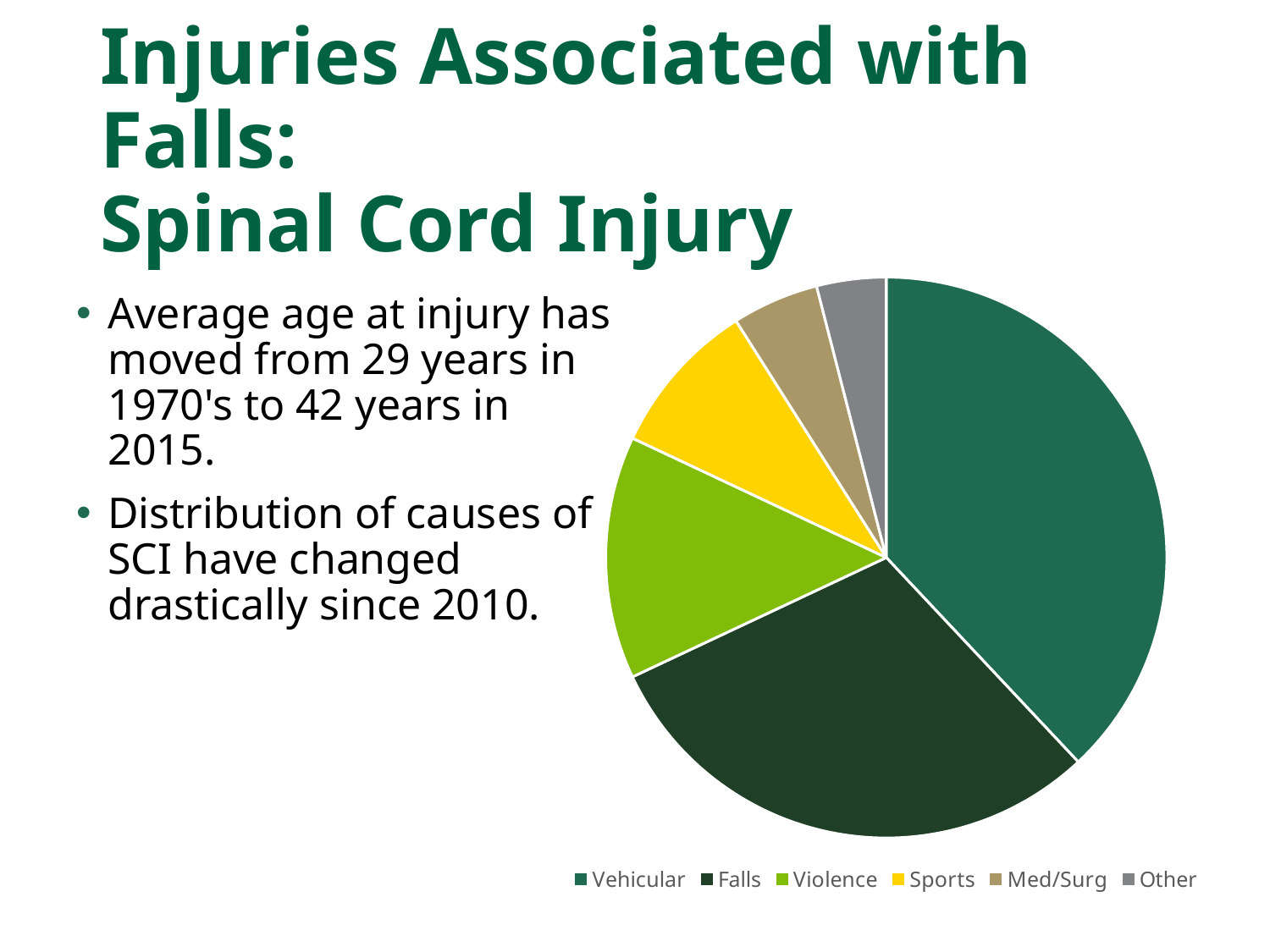
Which slice is larger in the pie chart, Falls or Sports? Falls Which category has the largest slice of the pie chart? Vehicular What kind of chart is shown on the slide? Pie chart Which slice is larger in the pie chart, Vehicular or Falls? Vehicular Which category is listed first in the pie chart's legend? Vehicular Which slice is larger in the pie chart, Sports or Other? Sports Which category is shown in yellow in the pie chart? Sports How many categories does the pie chart's legend list? 6